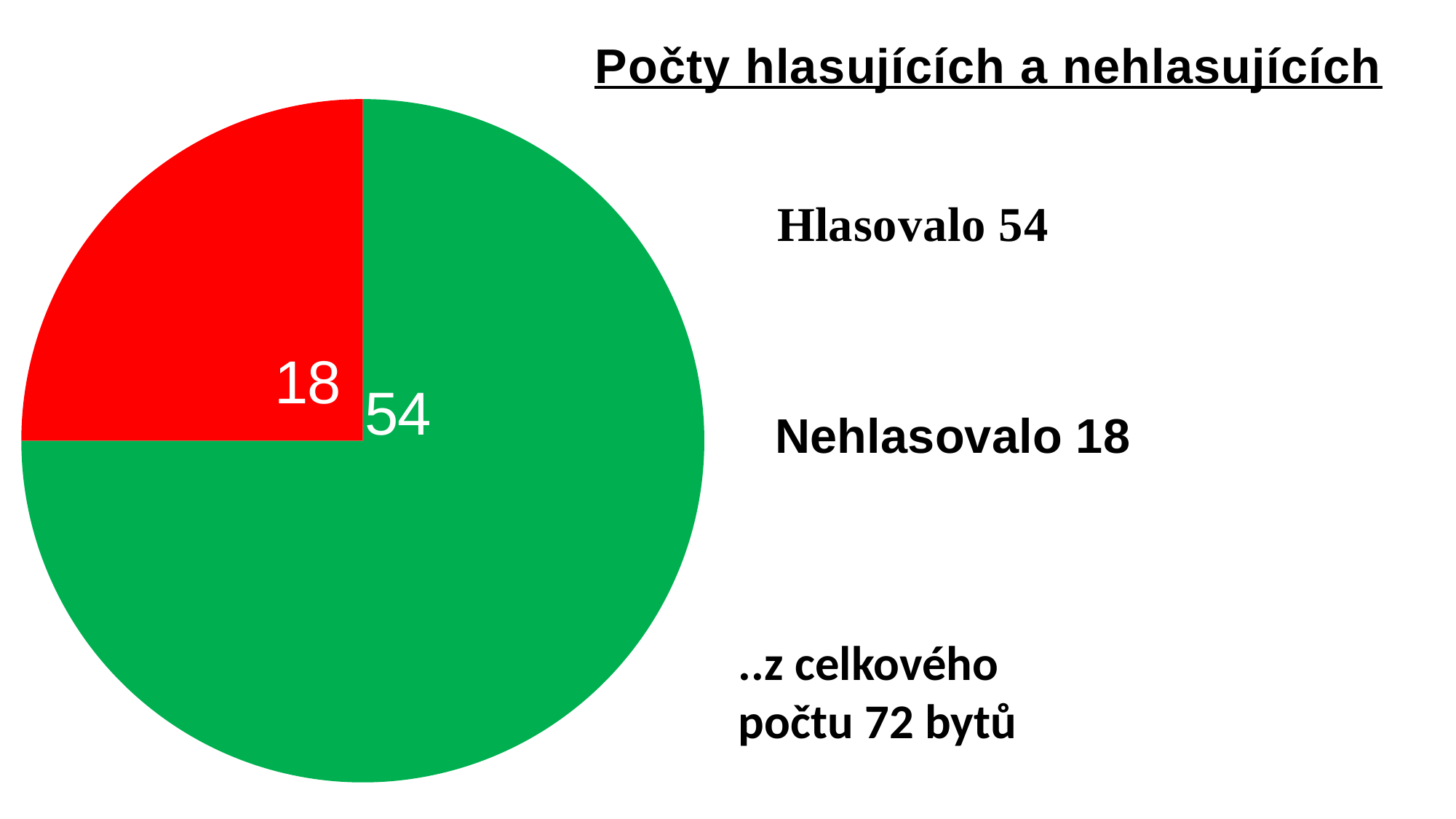
Which slice is larger, Hlasovalo or Nehlasovalo? Hlasovalo What colour is the Nehlasovalo slice? red What is the total of the two slices in the pie chart? 72 What is the value of the red slice (Nehlasovalo)? 18 What share of the pie does the Hlasovalo slice represent? 75% Which category has the smallest slice? Nehlasovalo What kind of chart is shown on the slide? pie chart How many slices does the pie chart have? 2 What is the title of the chart? Počty hlasujících a nehlasujících What share of the pie does the Nehlasovalo slice represent? 25% What is the difference between the Hlasovalo and Nehlasovalo values? 36 What is the value of the green slice (Hlasovalo)? 54